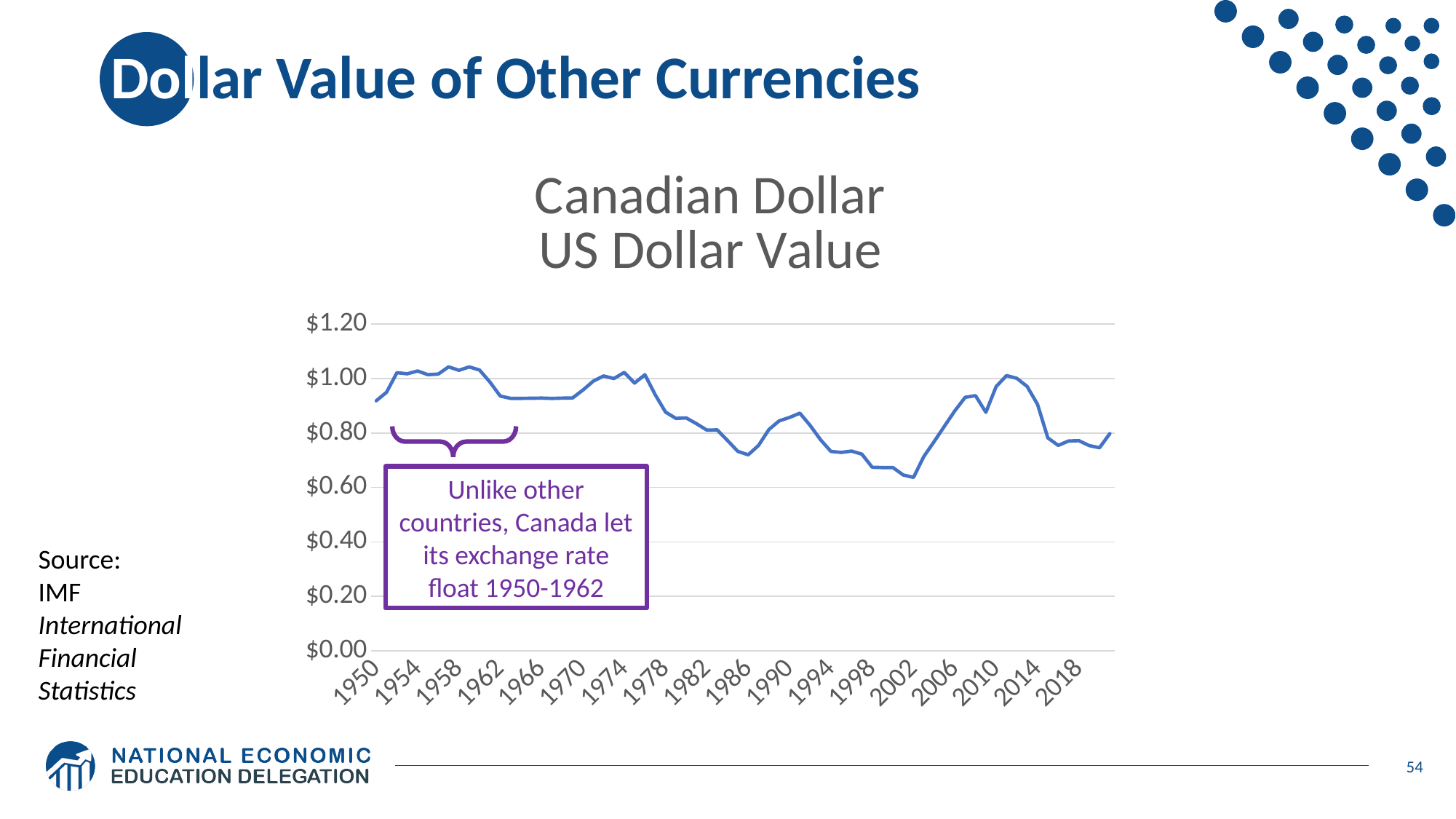
Is the value for 2010 greater or less than $0.80? greater Is the value for 2002 greater or less than $0.80? less Around which labelled year is the value lowest? 2002 How many year labels are shown on the x axis? 18 Is the value for 1966 greater or less than $0.80? greater Does the value rise or fall between 1974 and 1986? Fall Does the value rise or fall between 2002 and 2010? Rise What kind of chart is shown on the slide? Line chart According to the annotation, during which years did Canada let its exchange rate float? 1950-1962 What is the title of the chart? Canadian Dollar US Dollar Value